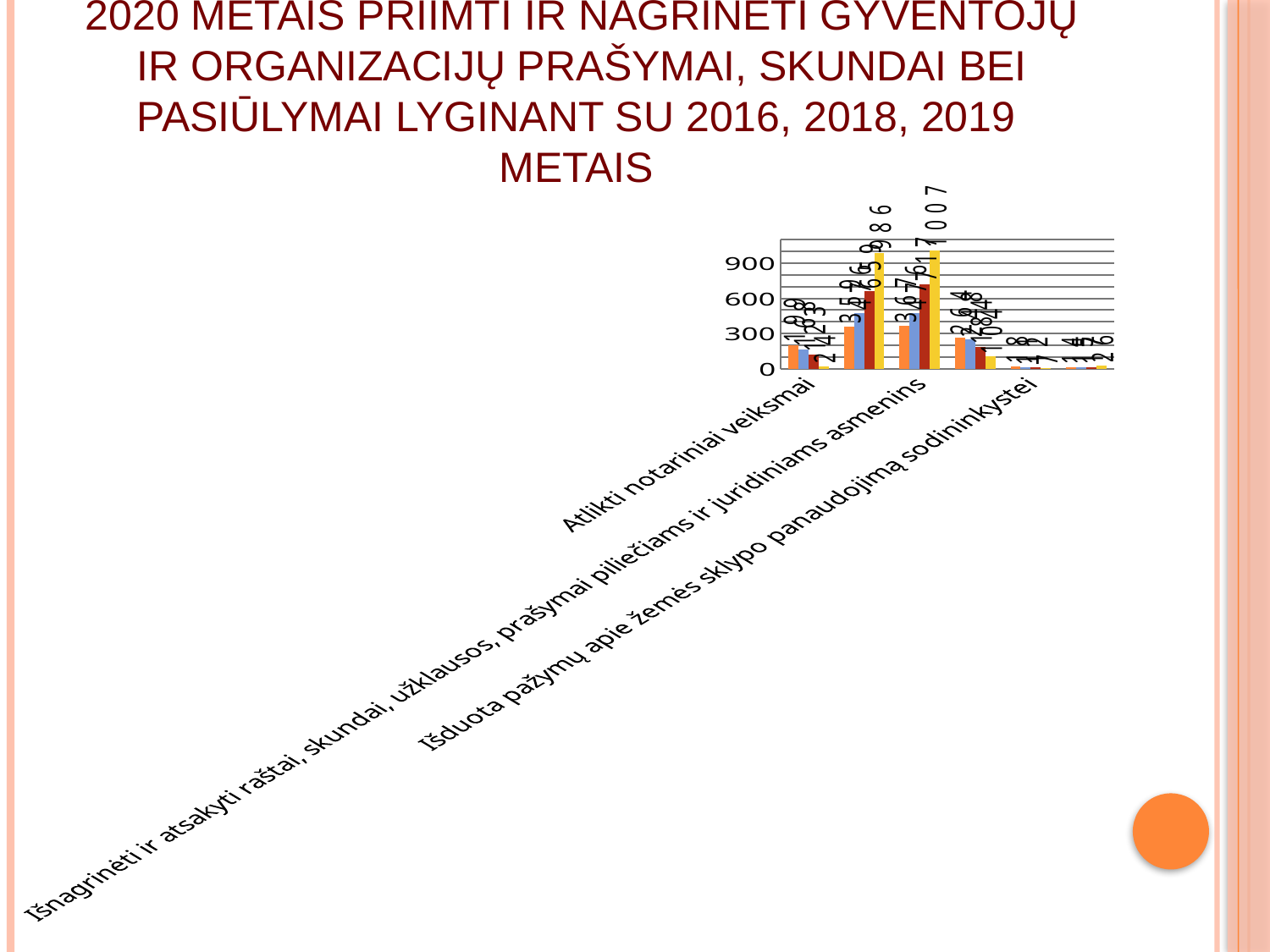
What is the largest data label printed on the chart? 1007 Are the bars for "Atlikti notariniai veiksmai" greater or less than 300? less Are the bars for "Išduota pažymų apie žemės sklypo panaudojimą sodininkystei" greater or less than 300? less Which of the labelled categories has the lowest bars? Išduota pažymų apie žemės sklypo panaudojimą sodininkystei Which category has the tallest bar: "Atlikti notariniai veiksmai" or "Išnagrinėti ir atsakyti raštai, skundai, užklausos, prašymai piliečiams ir juridiniams asmenins"? Išnagrinėti ir atsakyti raštai, skundai, užklausos, prašymai piliečiams ir juridiniams asmenins What kind of chart is shown on the slide? bar chart What colour is the bar with the data label 1007? yellow Is the tallest bar for "Išnagrinėti ir atsakyti raštai, skundai, užklausos, prašymai piliečiams ir juridiniams asmenins" greater or less than 900? greater What tick values are shown on the vertical axis? 0, 300, 600, 900